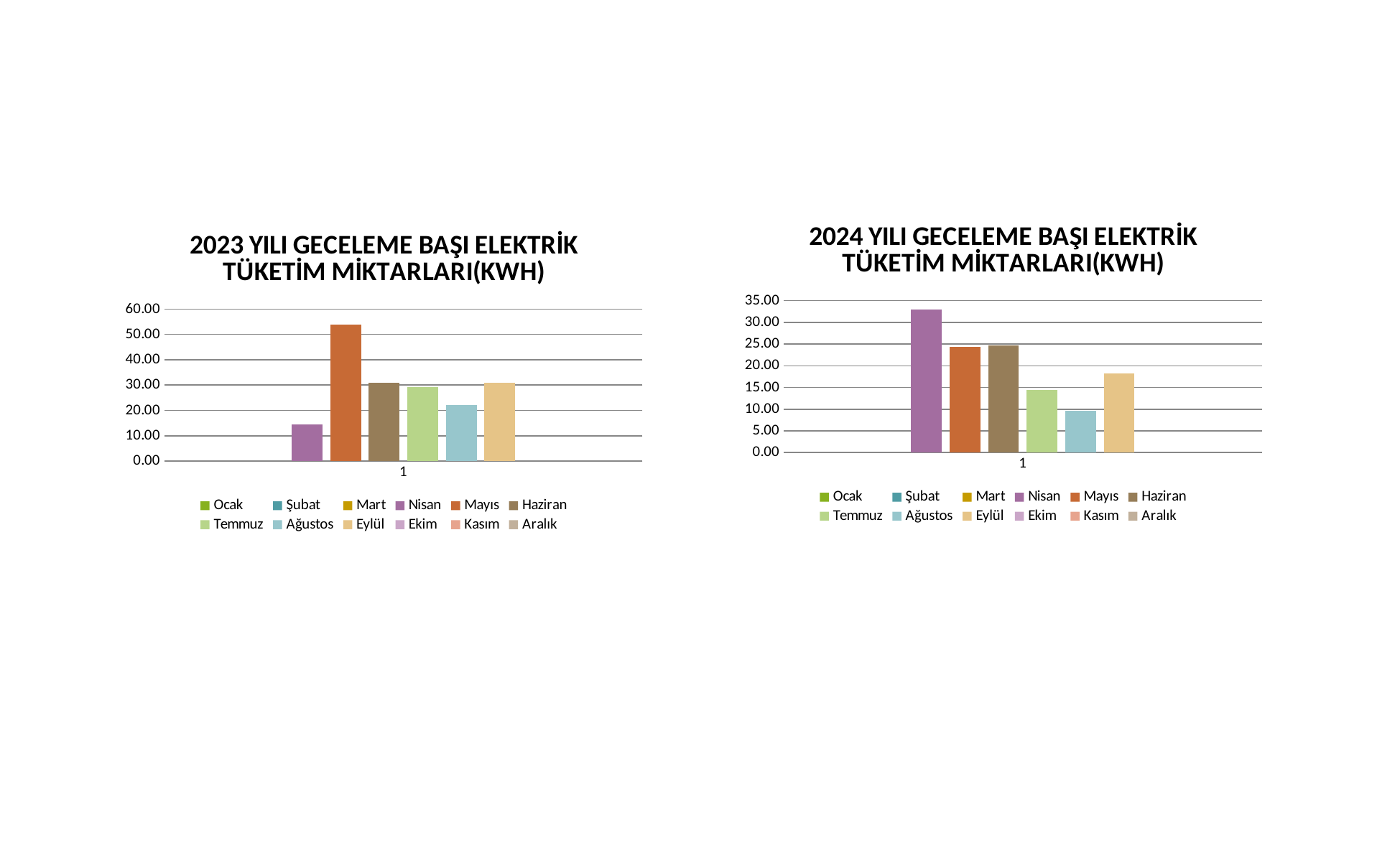
In the 2023 chart, which is larger, the value for Mayıs or the value for Ağustos? Mayıs In the 2024 chart, is the value for Ağustos greater or less than 15? less In the 2023 chart, is the value for Nisan greater or less than 20? less In the 2024 chart, which month has the highest value? Nisan What kind of chart is the 2024 chart? bar chart In the 2024 chart, is the value for Nisan greater or less than 30? greater In the 2024 chart, which of the plotted months has the lowest value? Ağustos How many series does the legend of the 2023 chart list? 12 In the 2023 chart, which month has the highest electricity consumption? Mayıs In the 2024 chart, which is larger, the value for Eylül or the value for Temmuz? Eylül In the 2023 chart, which of the plotted months has the lowest value? Nisan